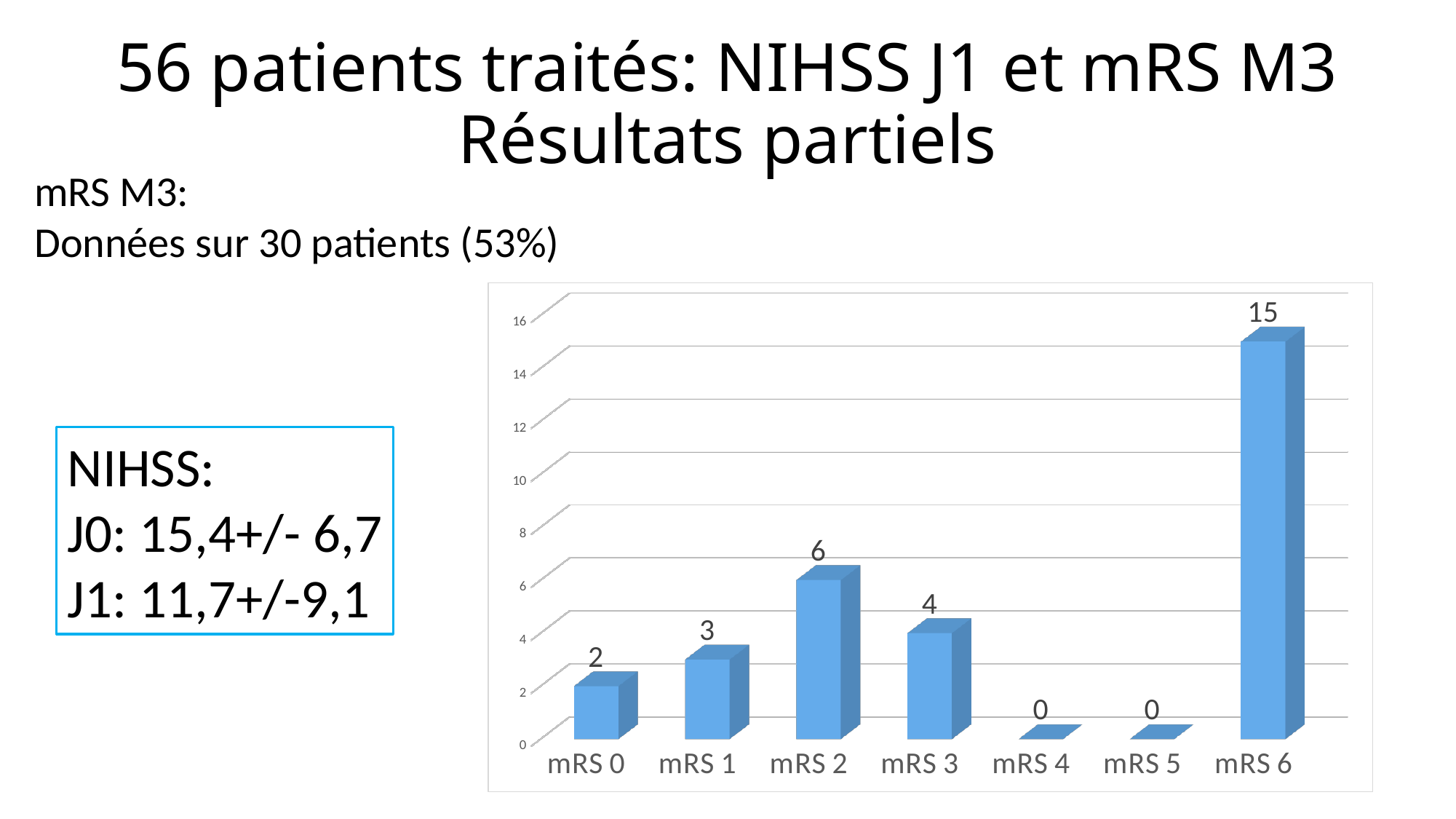
What is the total of all the bar values in the chart? 30 What is the value for mRS 0? 2 What is the value for mRS 6? 15 What kind of chart is shown on the slide? bar chart Which category has the highest value? mRS 6 What is the value for mRS 2? 6 How many categories are shown on the x axis? 7 Which is larger, the value for mRS 2 or the value for mRS 3? mRS 2 What is the value for mRS 4? 0 What is the difference between the values for mRS 3 and mRS 1? 1 What is the difference between the values for mRS 6 and mRS 2? 9 Is the value for mRS 6 greater or less than 14? greater